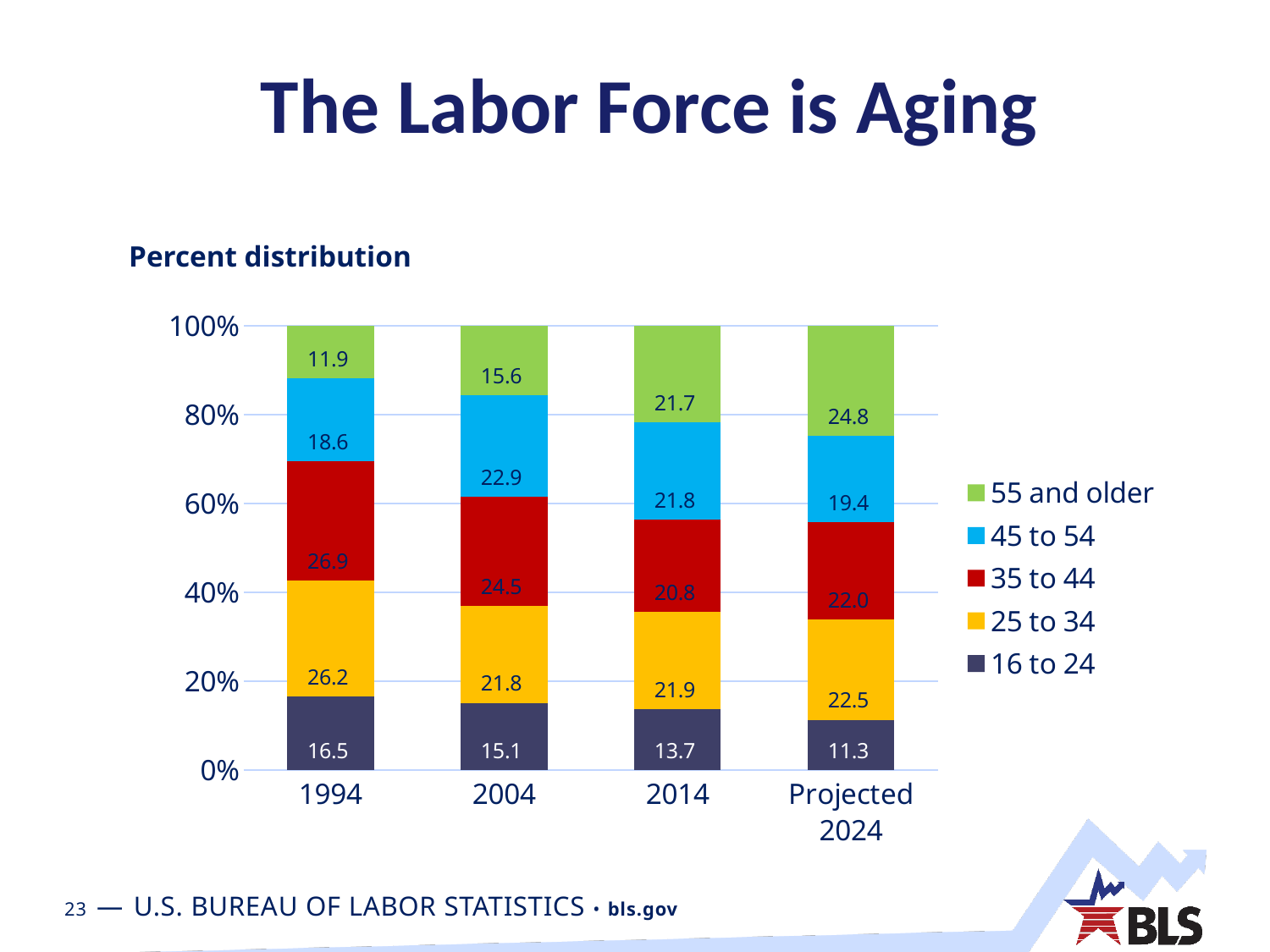
Which colour represents the 25 to 34 group in the legend? Yellow How many categories are shown on the x axis? 4 In which year is the 16 to 24 share the lowest? Projected 2024 How many series does the legend list? 5 Which is larger, the 45 to 54 value in 2004 or in 2014? 2004 What is the value for the 55 and older group in 1994? 11.9 What is the difference between the 55 and older value in Projected 2024 and in 1994? 12.9 What kind of chart is shown on the slide? Stacked bar chart In which year is the 55 and older share the highest? Projected 2024 What is the value for the 35 to 44 group in 2004? 24.5 Does the 16 to 24 share rise or fall from 1994 to Projected 2024? Fall What is the value for the 16 to 24 group in Projected 2024? 11.3